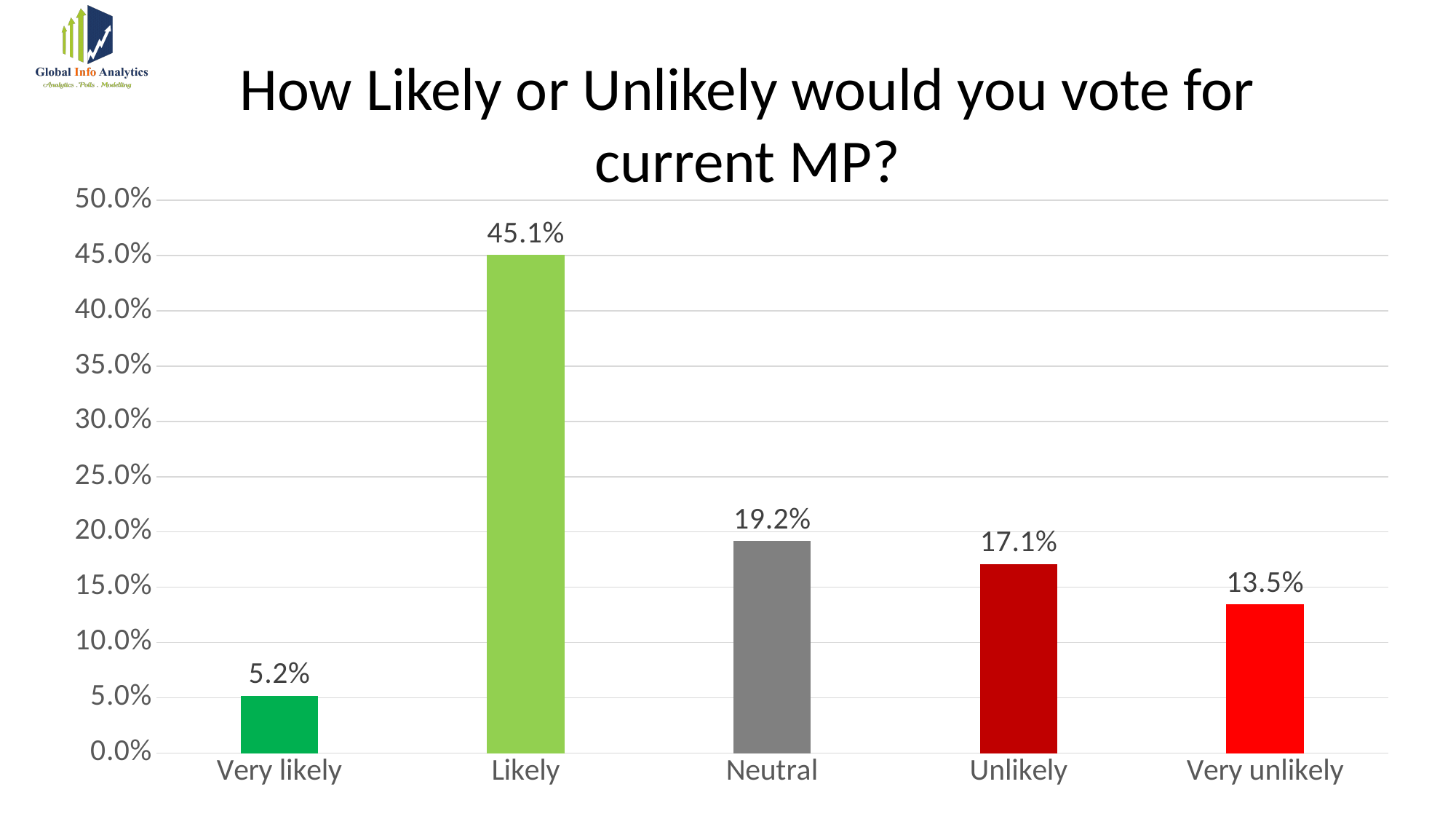
What is the value for Neutral? 19.2% What is the difference between the values for Likely and Very likely? 39.9% What is the value for Likely? 45.1% Is the value for Neutral greater or less than 20.0%? less Which is larger, the value for Unlikely or the value for Very unlikely? Unlikely What is the value for Very unlikely? 13.5% What is the difference between the values for Neutral and Unlikely? 2.1% Which category has the lowest value? Very likely How many categories are shown on the x axis? 5 What kind of chart is shown on the slide? bar chart What is the title of the chart? How Likely or Unlikely would you vote for current MP? Which category has the highest value? Likely